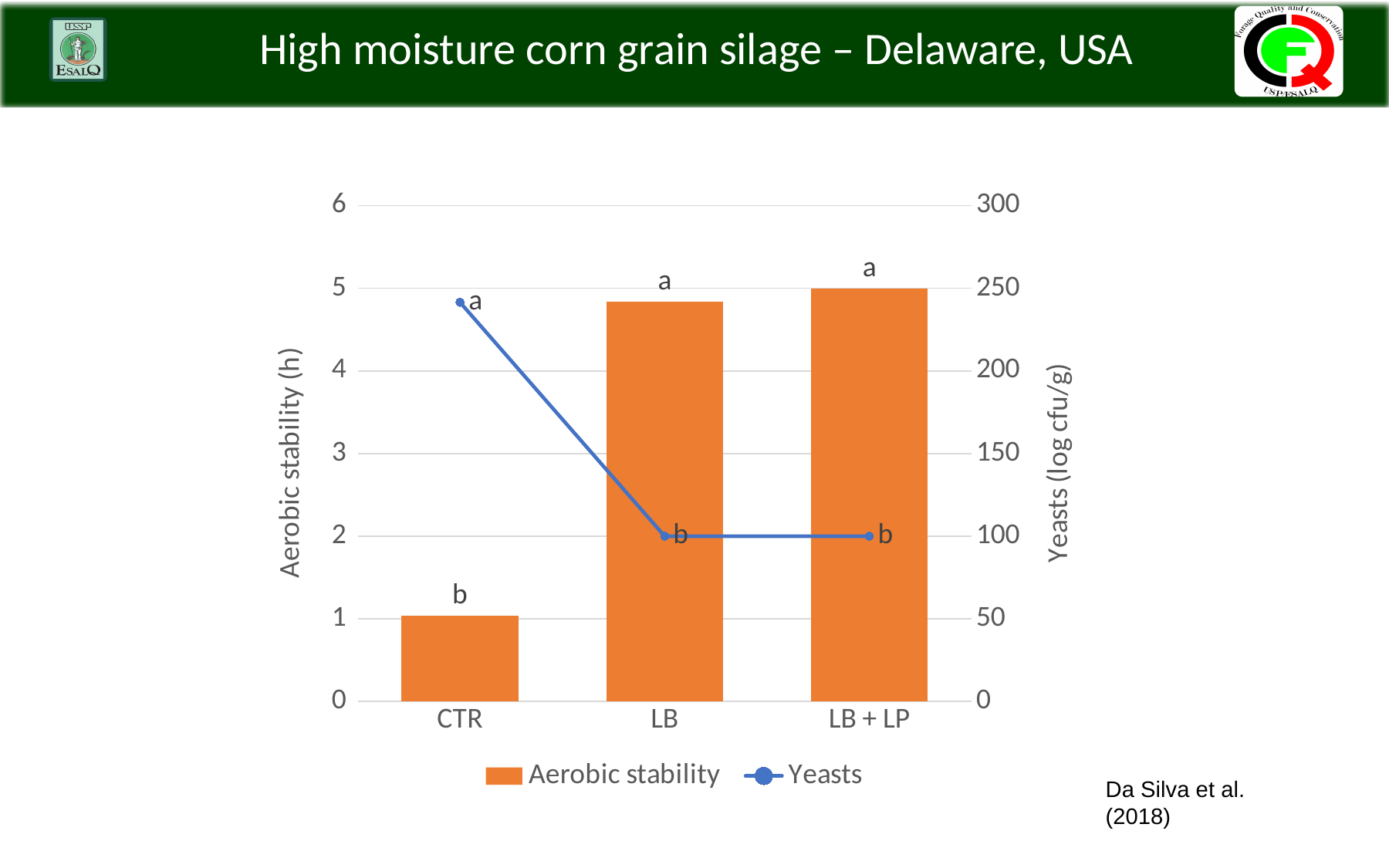
What is the label of the right-hand vertical axis? Yeasts (log cfu/g) Is the Aerobic stability value for LB greater or less than 4? greater Which has the higher Yeasts value, CTR or LB? CTR Which category has the highest Aerobic stability bar? LB + LP Which has the higher Aerobic stability, CTR or LB + LP? LB + LP How many series does the legend list? 2 Is the Yeasts value for LB + LP greater or less than 150? less Does the Yeasts line rise or fall from CTR to LB? fall How many categories are shown on the x axis? 3 Which category has the lowest Aerobic stability bar? CTR